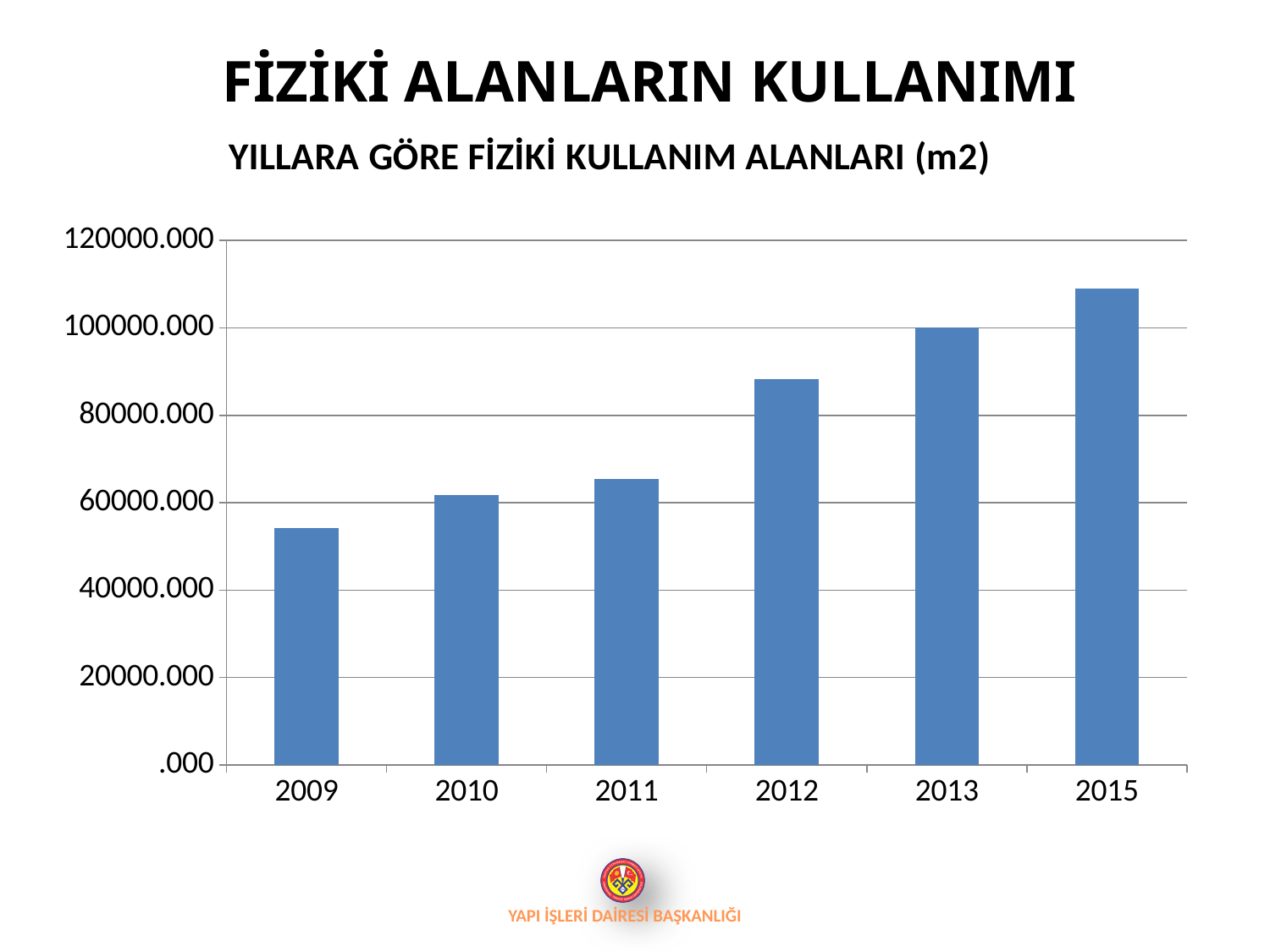
Is the value for 2009 greater or less than 60000.000? less Which is larger, the value for 2012 or the value for 2011? 2012 Is the value for 2011 greater or less than 80000.000? less Is the value for 2012 greater or less than 80000.000? greater What kind of chart is shown on the slide? bar chart Which is larger, the value for 2009 or the value for 2010? 2010 Do the values rise or fall from 2009 to 2015 along the x axis? rise Which year has the lowest value in the chart? 2009 Which year has the highest value in the chart? 2015 How many years are shown on the x axis of the chart? 6 What is the title of the chart? YILLARA GÖRE FİZİKİ KULLANIM ALANLARI (m2)